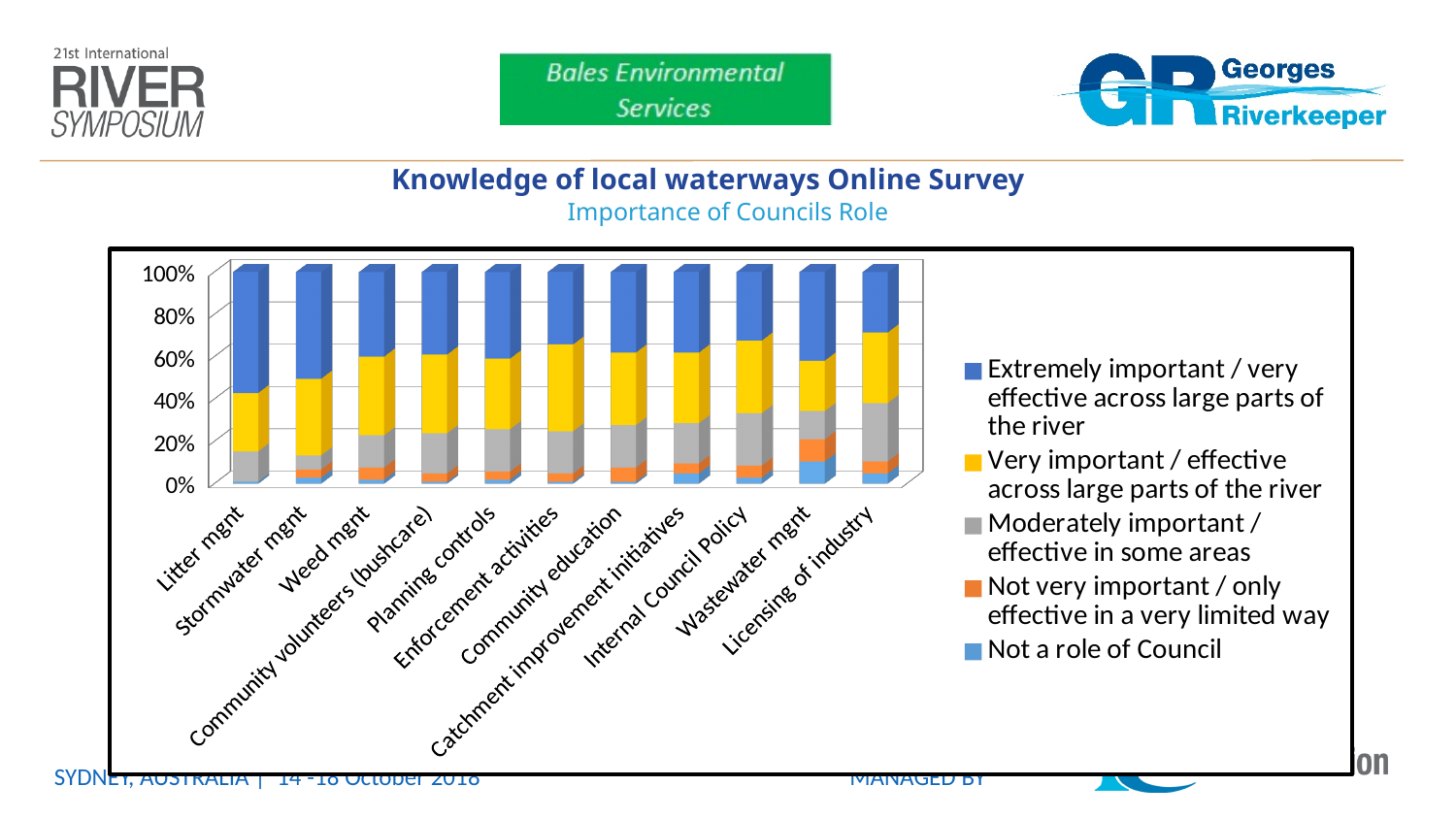
Is the 'Not a role of Council' share for Wastewater mgnt greater or less than 20%? less How many series does the chart's legend list? 5 How many categories are shown along the x axis of the chart? 11 Is the 'Extremely important / very effective across large parts of the river' segment larger for Litter mgnt or for Licensing of industry? Litter mgnt Which category has the largest 'Not a role of Council' segment? Wastewater mgnt Which category has the largest 'Extremely important / very effective across large parts of the river' segment? Litter mgnt Which category has the smallest 'Extremely important / very effective across large parts of the river' segment? Licensing of industry Which colour represents 'Very important / effective across large parts of the river' in the legend? Yellow What does each stacked bar in the chart total? 100% Is the 'Extremely important / very effective across large parts of the river' share for Litter mgnt greater or less than 40%? greater What kind of chart is shown on the slide? Stacked bar chart What is the subtitle of the chart shown on the slide? Importance of Councils Role